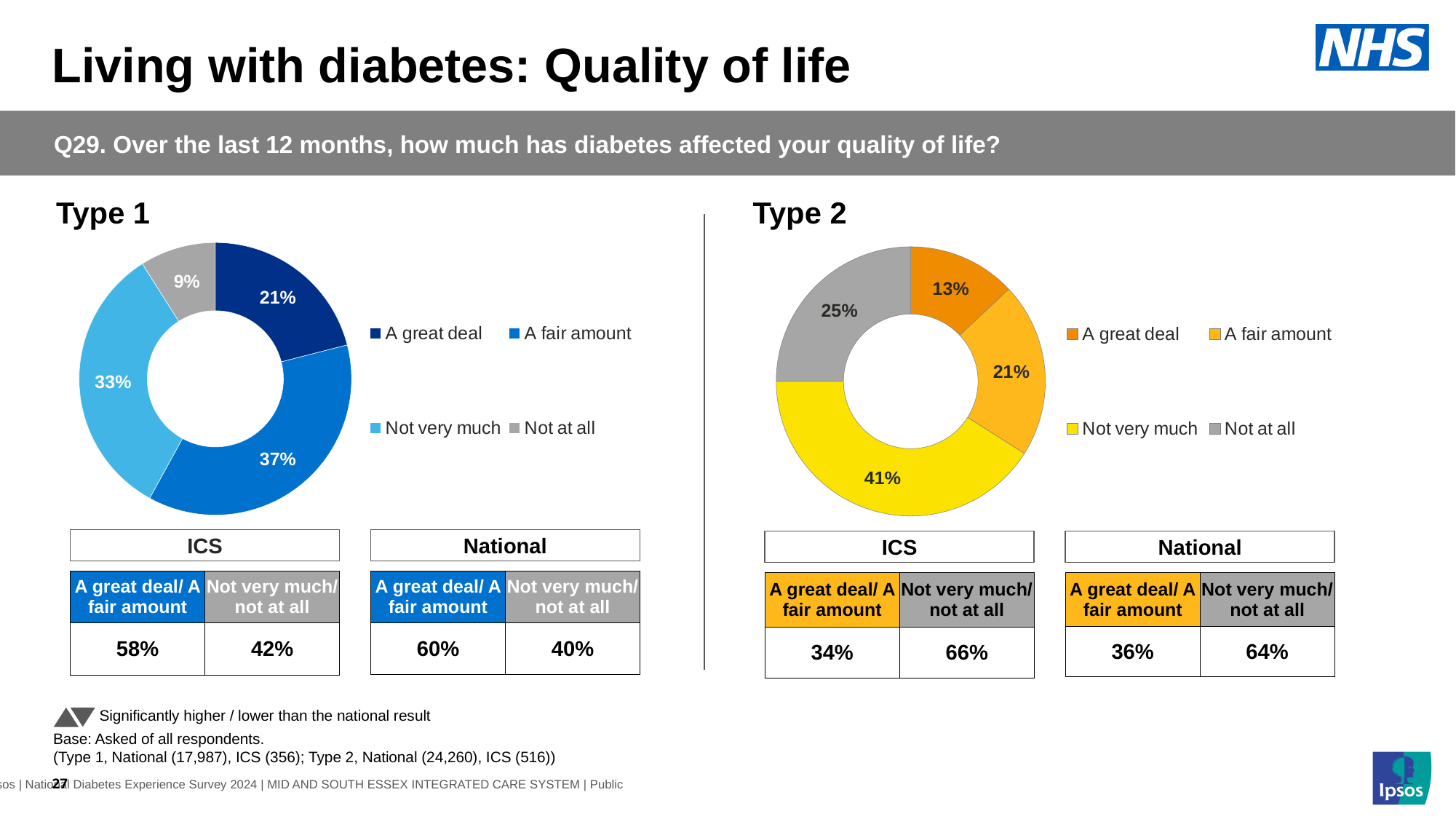
What kind of chart is used for Type 2? Donut (pie) chart How many categories does the Type 1 chart show? 4 In the Type 2 chart, which category has the smallest share? A great deal In the Type 1 chart, which category has the largest share? A fair amount In the Type 1 chart, what percentage of respondents said diabetes affected their quality of life 'A fair amount'? 37% In the Type 1 chart, what percentage said 'Not at all'? 9% In the Type 2 chart, what percentage said 'A great deal'? 13% In the Type 1 chart, what colour represents 'Not very much'? Light blue In the Type 2 chart, what is the difference between the 'Not very much' and 'Not at all' shares? 16 percentage points In the Type 2 chart, what percentage of respondents said 'Not very much'? 41% In the Type 1 chart, what is the difference between the 'A fair amount' and 'Not very much' shares? 4 percentage points Which is larger in the Type 2 chart: 'A fair amount' or 'Not at all'? Not at all